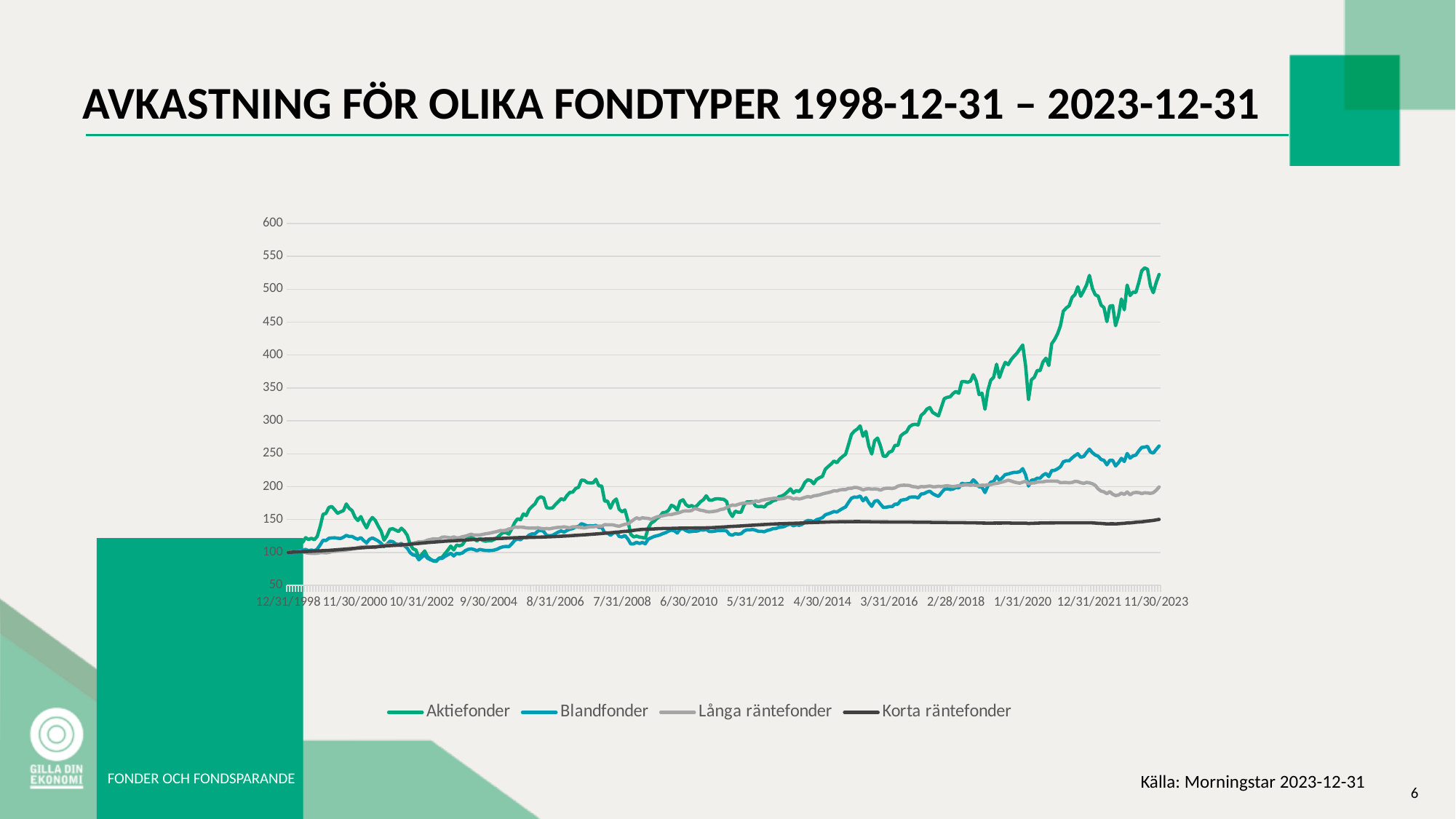
Which series is drawn as the dark grey/black line in the legend? Korta räntefonder Does the Aktiefonder series rise or fall overall from 1998 to 2023? rise Is the value for Långa räntefonder at the end of the period greater or less than 250? less What is the title of the chart on the slide? AVKASTNING FÖR OLIKA FONDTYPER 1998-12-31 – 2023-12-31 Which series has the highest value at the end of the period (11/30/2023)? Aktiefonder What kind of chart is shown on the slide? line chart Is the value for Aktiefonder at the end of the period greater or less than 500? greater How many series does the legend list? 4 Is the value for Korta räntefonder at the end of the period greater or less than 200? less At the end of the period, which is higher: Blandfonder or Långa räntefonder? Blandfonder Which series has the lowest value at the end of the period (11/30/2023)? Korta räntefonder